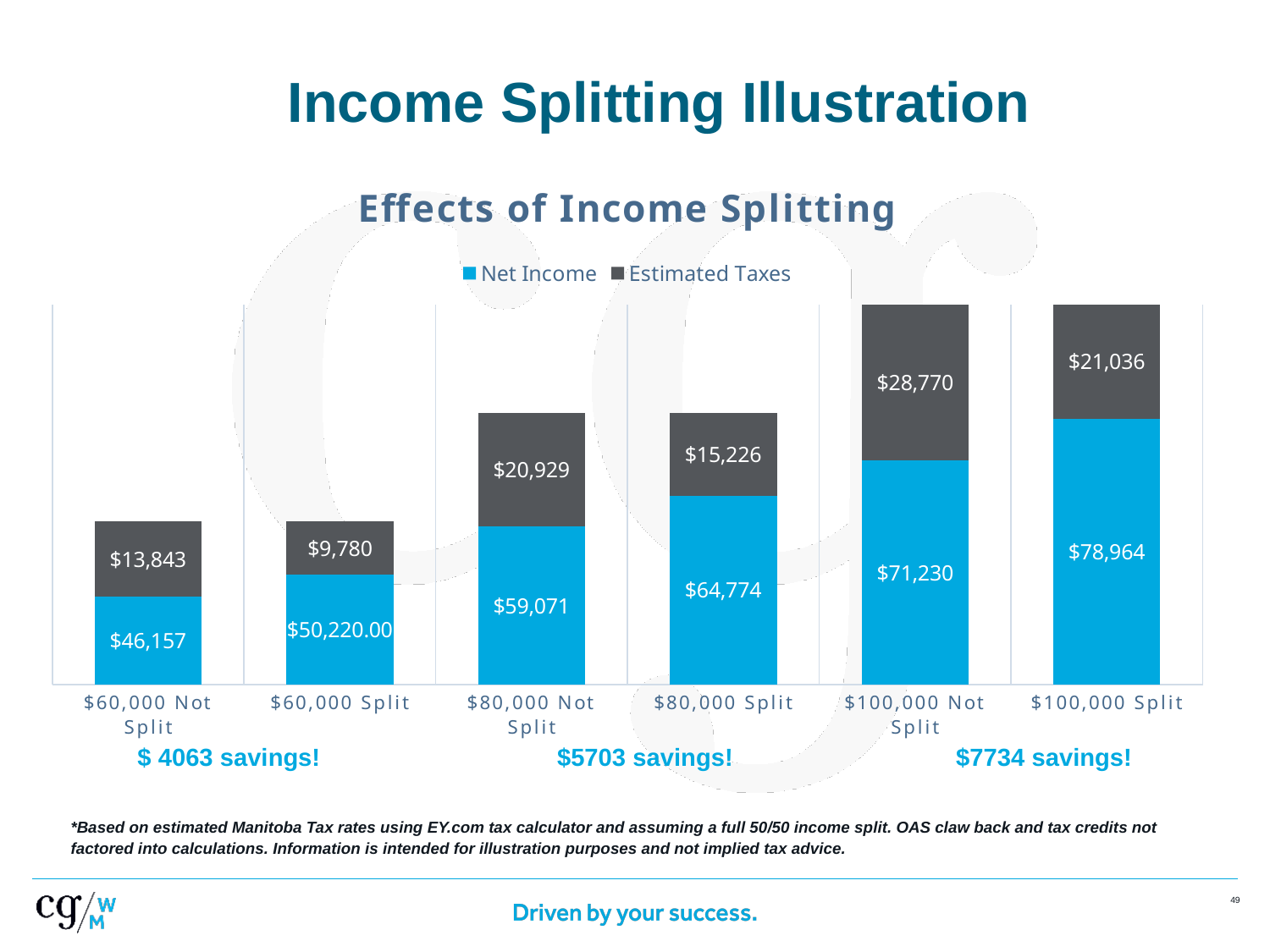
How many series does the legend list? 2 Which category has the lowest Estimated Taxes value? $60,000 Split What is the Net Income value for the $60,000 Not Split bar? $46,157 What is the Net Income value for the $80,000 Split bar? $64,774 What is the total of the $60,000 Not Split stacked bar (Net Income plus Estimated Taxes)? $60,000 What is the Estimated Taxes value for the $100,000 Split bar? $21,036 Which has the larger Net Income, $80,000 Not Split or $80,000 Split? $80,000 Split What is the difference between the Estimated Taxes for $60,000 Not Split and $60,000 Split? $4,063 Which category has the highest Estimated Taxes value? $100,000 Not Split What kind of chart is shown? Stacked bar chart How many categories are shown on the x axis? 6 What is the difference in Net Income between $100,000 Split and $100,000 Not Split? $7,734